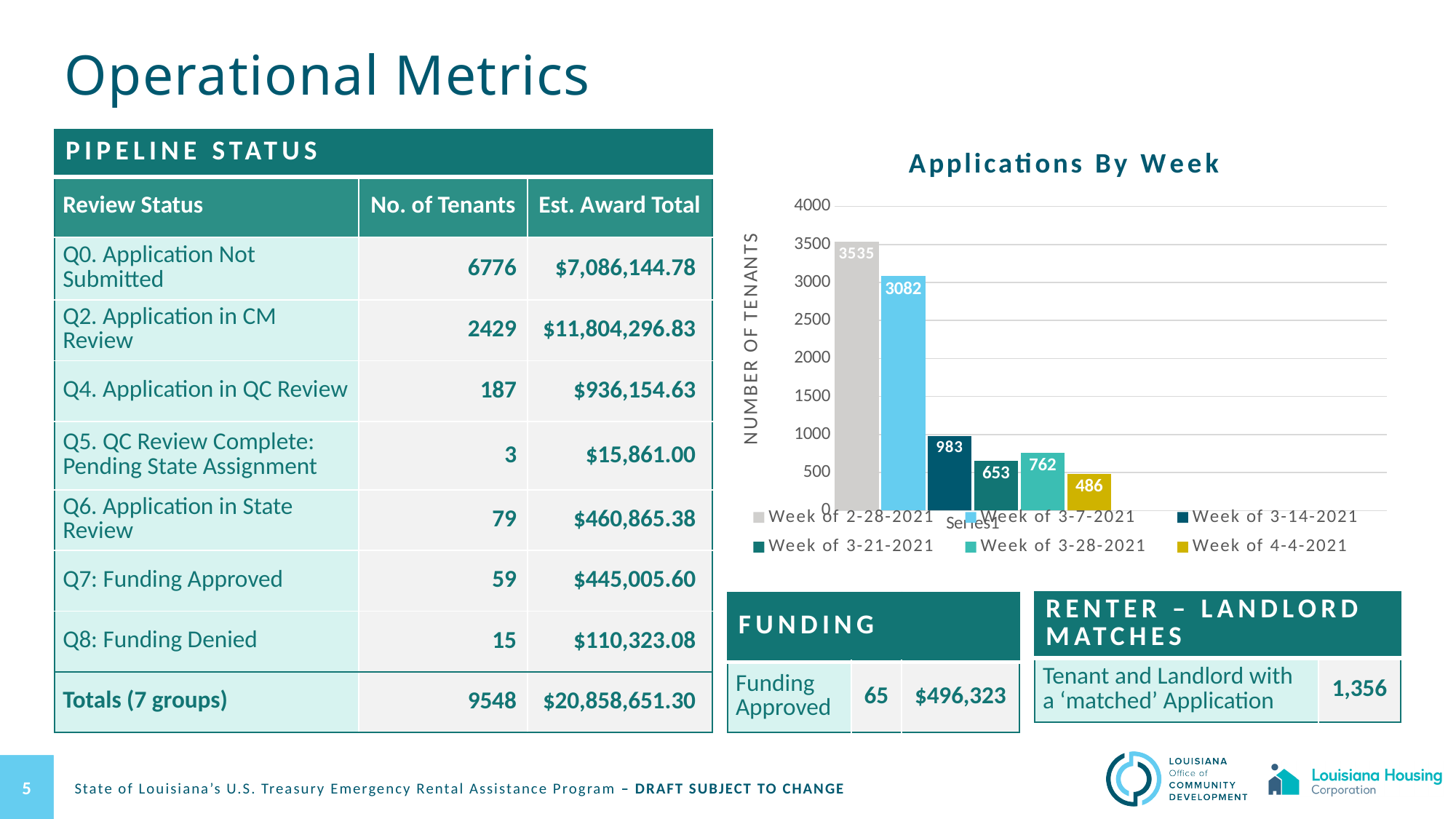
What is the label on the vertical axis of the "Applications By Week" chart? NUMBER OF TENANTS In the "Applications By Week" chart, which week has the lowest number of tenants? Week of 4-4-2021 In the "Applications By Week" chart, what is the difference between Week of 2-28-2021 and Week of 3-7-2021? 453 In the "Applications By Week" chart, what is the value for Week of 3-21-2021? 653 How many series does the legend of the "Applications By Week" chart list? 6 In the "Applications By Week" chart, what is the value for Week of 3-7-2021? 3082 In the "Applications By Week" chart, which is larger: Week of 3-14-2021 or Week of 3-28-2021? Week of 3-14-2021 In the "Applications By Week" chart, what is the value for Week of 2-28-2021? 3535 In the "Applications By Week" chart, which week has the highest number of tenants? Week of 2-28-2021 In the "Applications By Week" chart, what is the value for Week of 4-4-2021? 486 What type of chart is "Applications By Week"? bar chart What is the title of the chart on the slide? Applications By Week